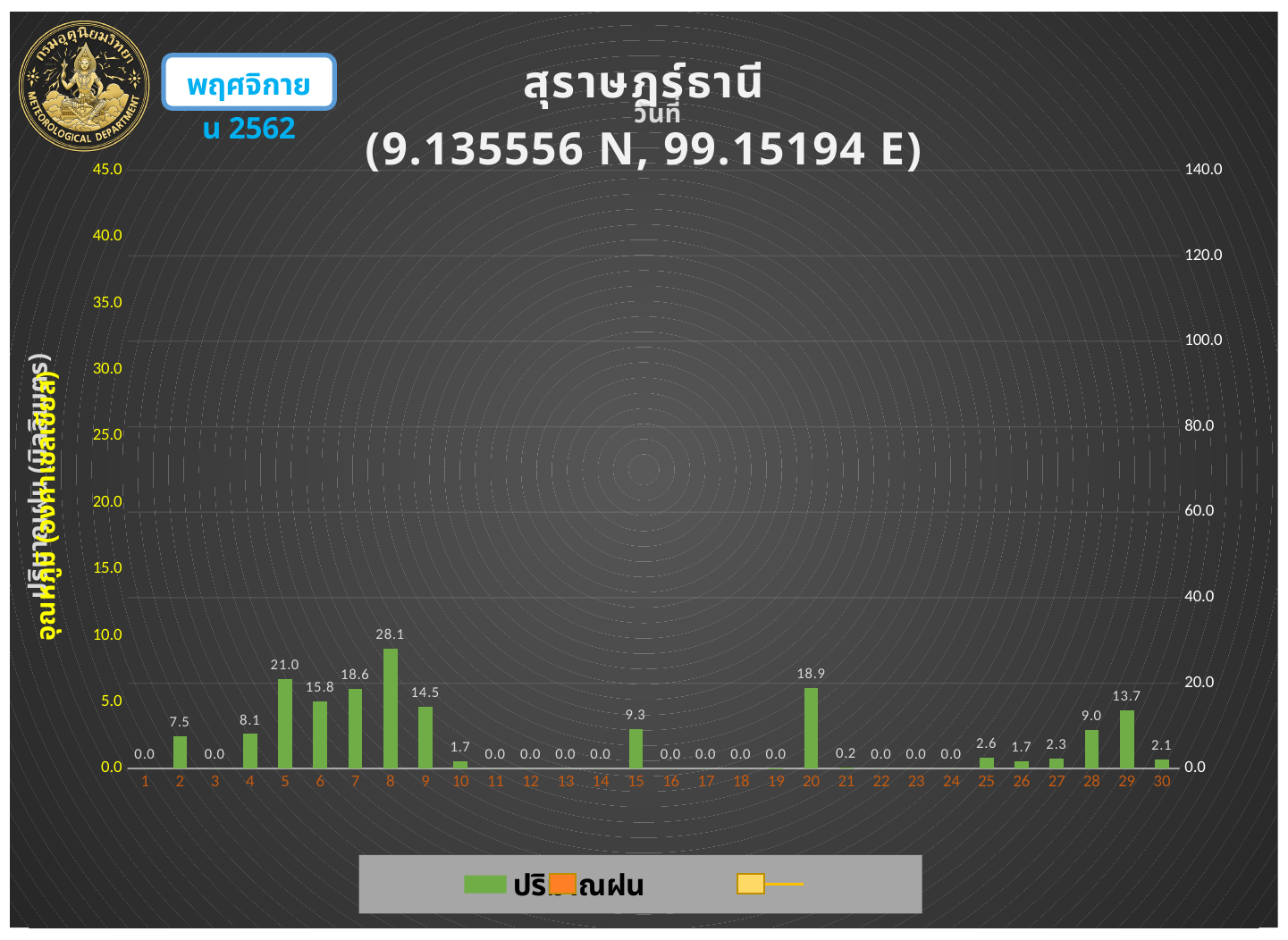
Which day has the highest value? 8 What is the value for day 21? 0.2 What is the value for day 8? 28.1 Which is larger, the value for day 28 or the value for day 29? day 29 Which is larger, the value for day 7 or the value for day 9? day 7 What is the difference between the values for day 5 and day 6? 5.2 What is the difference between the values for day 8 and day 20? 9.2 What is the value for day 20? 18.9 What is the value for day 15? 9.3 What is the value for day 29? 13.7 What kind of chart is shown on the slide? bar chart How many days are shown on the x axis? 30